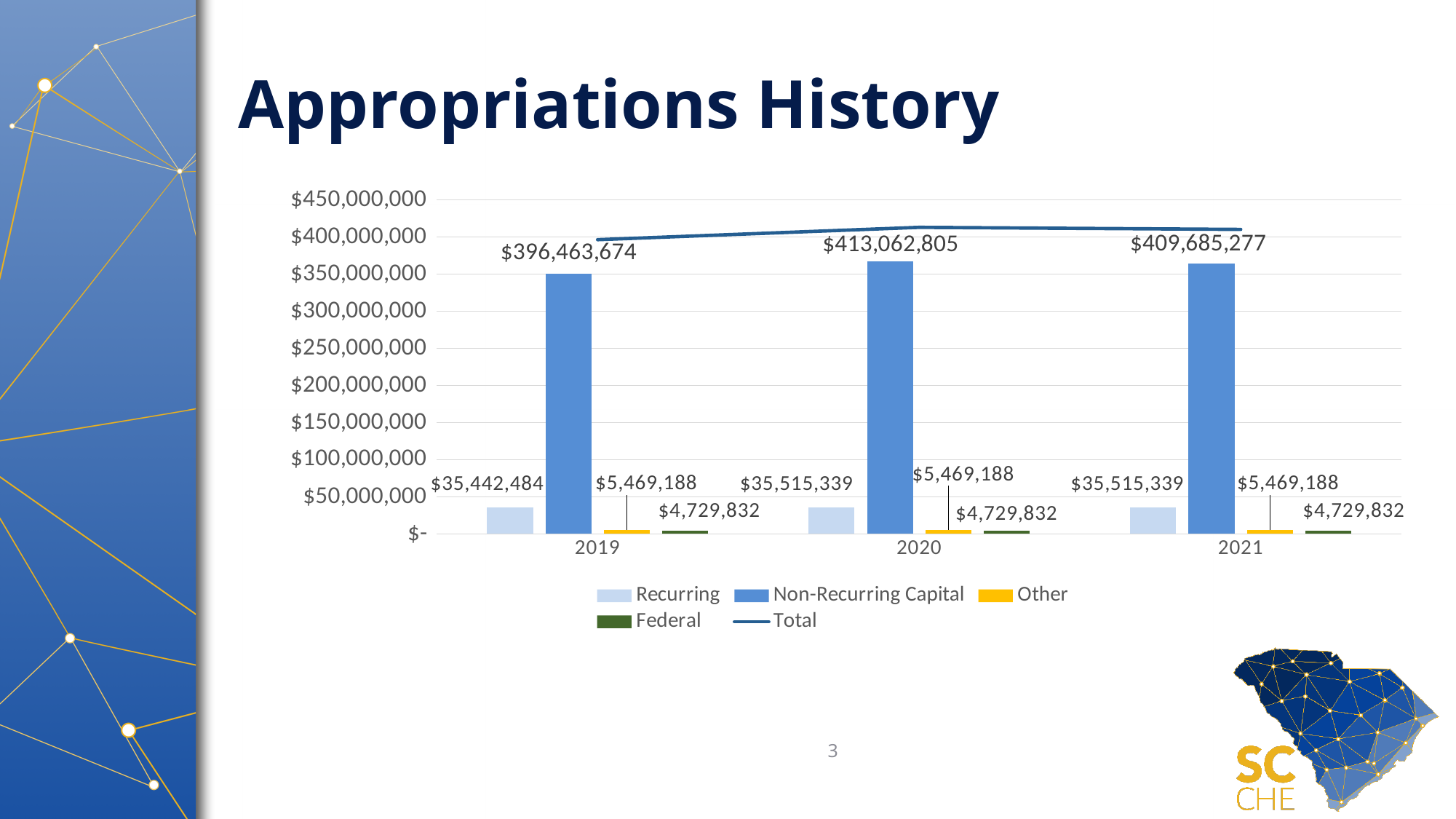
What is the Total value for 2020? $413,062,805 What is the Recurring value for 2019? $35,442,484 What is the Other value for 2020? $5,469,188 What is the difference between the Total for 2020 and the Total for 2019? $16,599,131 What is the Federal value for 2021? $4,729,832 Which is larger in 2021, the Other value or the Federal value? Other How many years are shown on the x axis? 3 Is the Non-Recurring Capital value for 2019 greater or less than $300,000,000? greater In which year is the Total lowest? 2019 In which year is the Total highest? 2020 How many series does the legend list? 5 What is the title of the slide containing the chart? Appropriations History